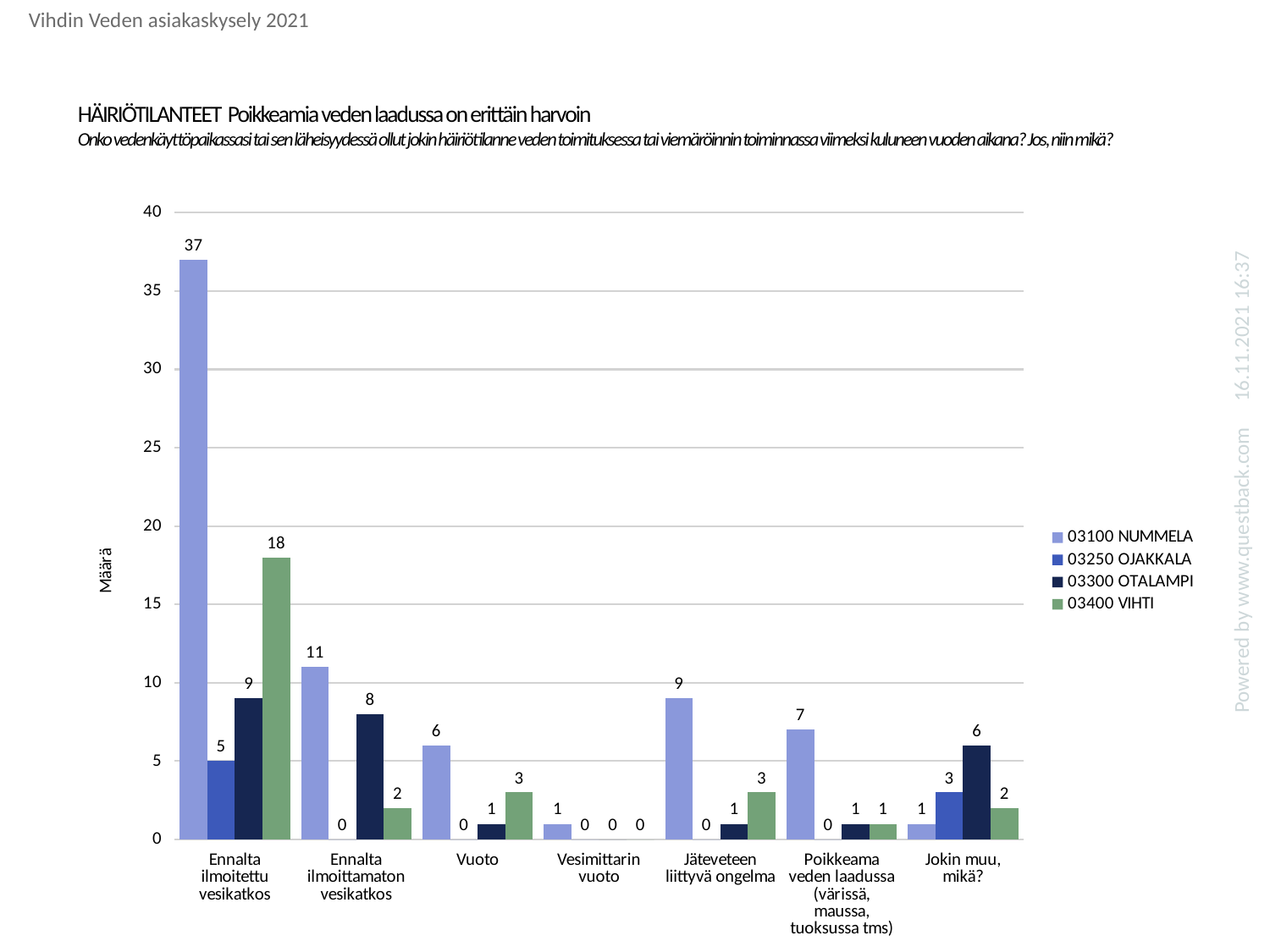
What is the label of the y axis? Määrä What kind of chart is shown on the slide? Bar chart How many series does the legend list? 4 What is the value for 03100 NUMMELA in the 'Ennalta ilmoitettu vesikatkos' category? 37 What is the difference between the 03100 NUMMELA and 03400 VIHTI values in the 'Ennalta ilmoitettu vesikatkos' category? 19 How many categories are shown on the x axis? 7 What is the value for 03300 OTALAMPI in the 'Ennalta ilmoittamaton vesikatkos' category? 8 Which series has the lowest value in the 'Ennalta ilmoitettu vesikatkos' category? 03250 OJAKKALA Which is larger in the 'Jokin muu, mikä?' category: 03300 OTALAMPI or 03400 VIHTI? 03300 OTALAMPI What is the value for 03400 VIHTI in the 'Ennalta ilmoitettu vesikatkos' category? 18 Which category has the highest value for 03100 NUMMELA? Ennalta ilmoitettu vesikatkos What is the value for 03250 OJAKKALA in the 'Jokin muu, mikä?' category? 3